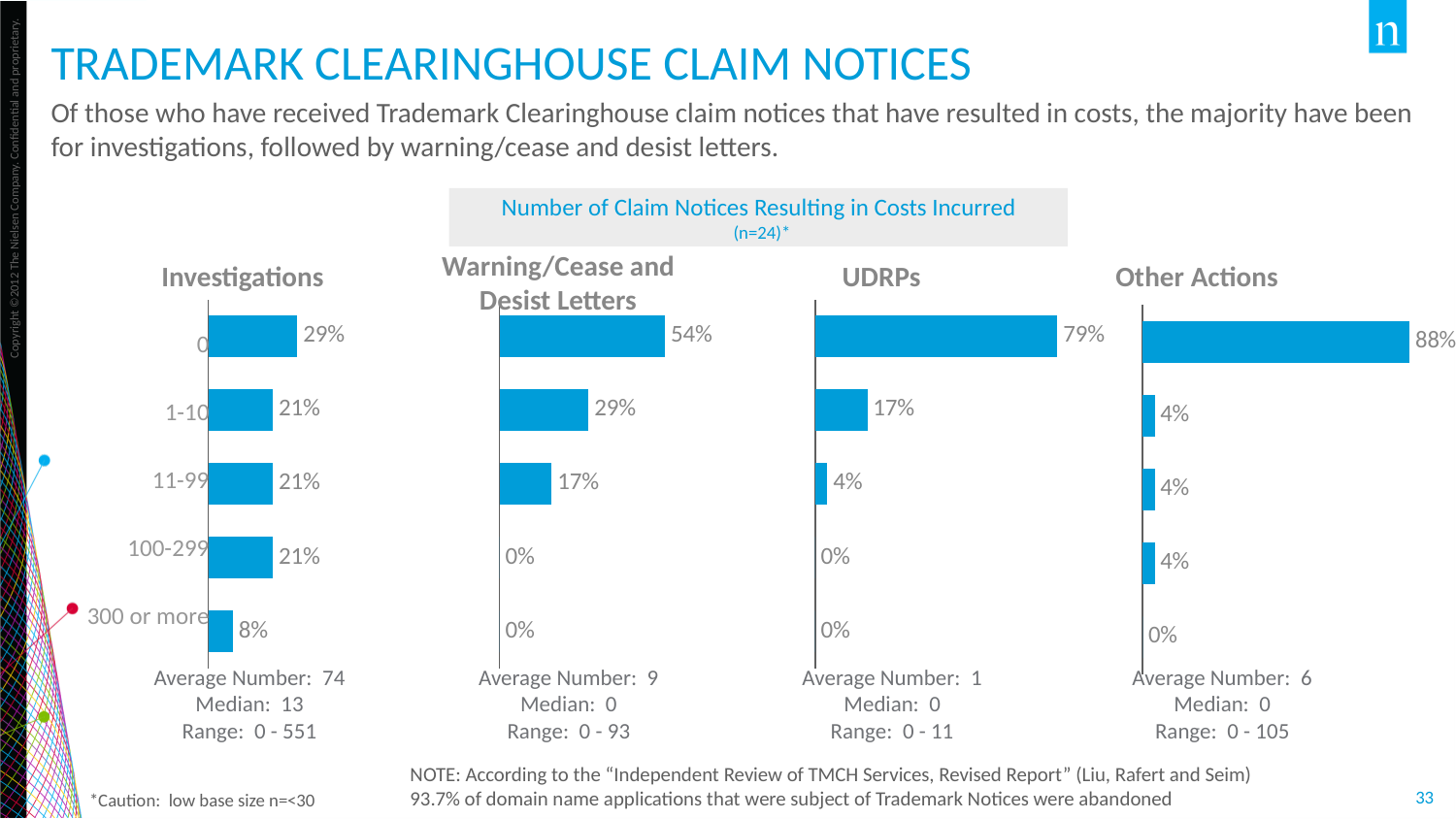
In the Other Actions chart, what percentage is shown for the '100-299' category? 4% In the Other Actions chart, which category has the highest percentage? 0 In the Warning/Cease and Desist Letters chart, what percentage is shown for the '1-10' category? 29% What type of chart is used for the Investigations data? Bar chart In the UDRPs chart, what percentage is shown for the '0' category? 79% Which is larger: the '0' percentage in the Warning/Cease and Desist Letters chart or the '0' percentage in the Other Actions chart? Other Actions In the Investigations chart, what percentage is shown for '300 or more'? 8% How many categories are shown in the Investigations chart? 5 In the UDRPs chart, what is the difference between the percentages for '0' and '1-10'? 62% What is the average number shown below the Investigations chart? 74 In the Investigations chart, which category has the lowest percentage? 300 or more In the Investigations chart, what percentage is shown for the '0' category? 29%